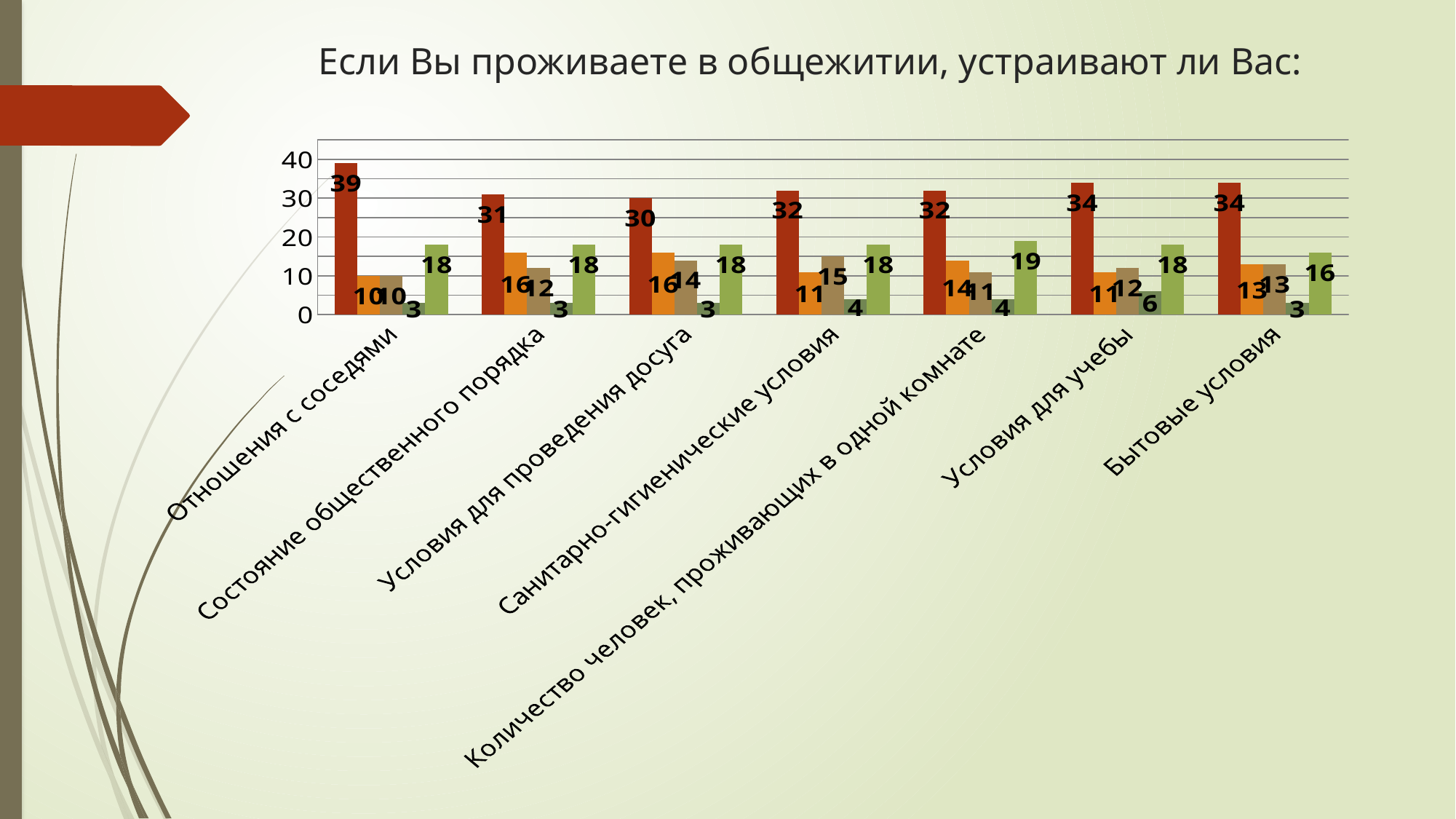
How many categories are shown on the x axis? 7 What is the value of the dark red bar for "Отношения с соседями"? 39 Which is larger for "Санитарно-гигиенические условия": the orange bar or the tan bar? the tan bar What is the value of the light green bar for "Количество человек, проживающих в одной комнате"? 19 Which category has the highest dark red bar? Отношения с соседями What is the value of the dark green bar for "Условия для учебы"? 6 What is the title of the slide? Если Вы проживаете в общежитии, устраивают ли Вас: Is the dark red bar for "Состояние общественного порядка" greater or less than 30? greater Which category has the lowest dark red bar? Условия для проведения досуга How many bars are shown for each category? 5 What is the difference between the dark red bar and the light green bar for "Бытовые условия"? 18 What kind of chart is shown on the slide? bar chart